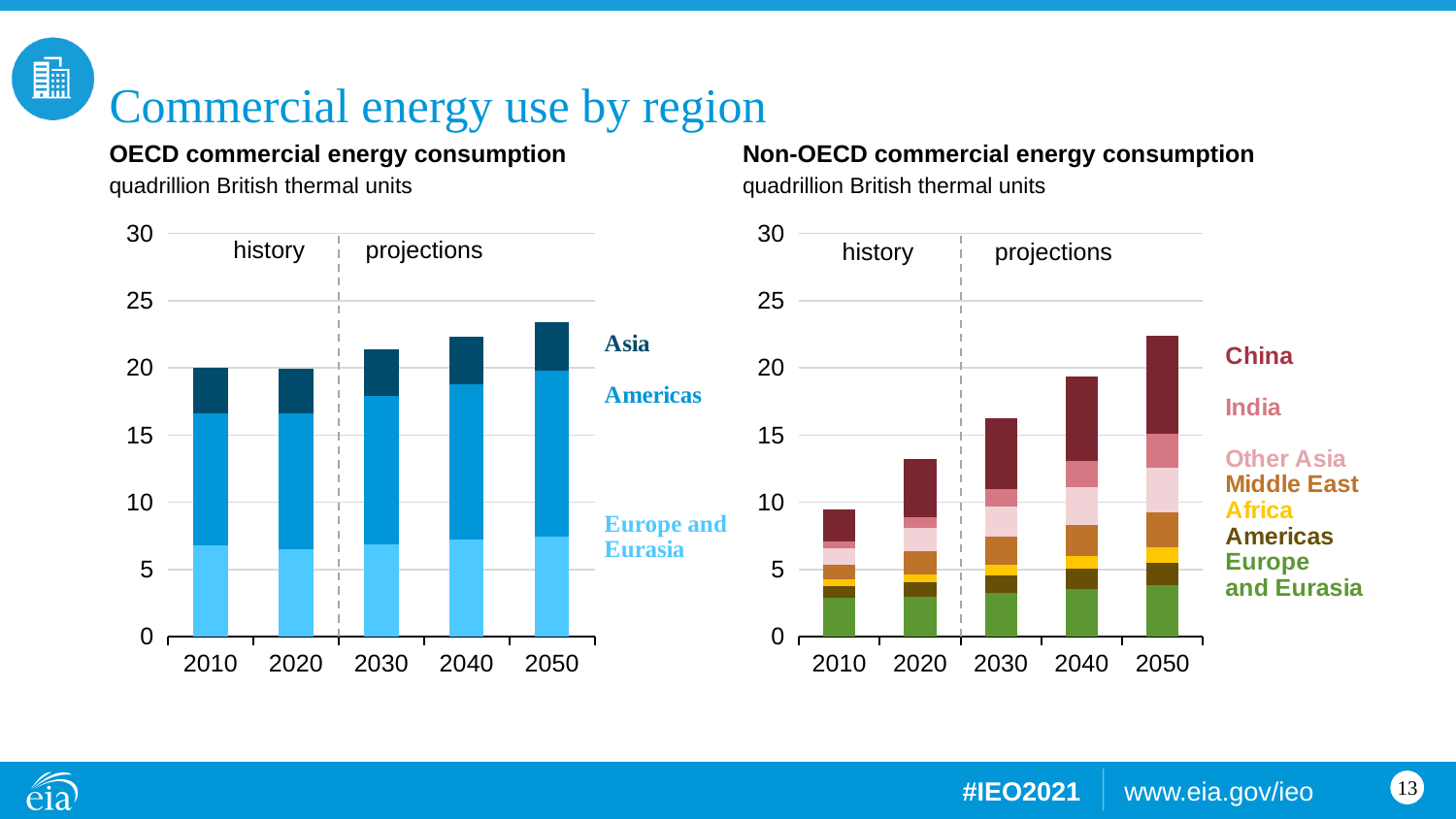
In the OECD commercial energy consumption chart, is the total for 2030 greater or less than 20? greater How many regions are listed in the legend of the Non-OECD commercial energy consumption chart? 7 In the OECD commercial energy consumption chart, which year has the highest total bar? 2050 Do the total bars in the Non-OECD commercial energy consumption chart rise or fall from 2010 to 2050? rise Which is larger in 2010: the total OECD commercial energy consumption or the total Non-OECD commercial energy consumption? OECD How many years are shown on the x axis of the Non-OECD commercial energy consumption chart? 5 How many regions are listed in the legend of the OECD commercial energy consumption chart? 3 In the Non-OECD commercial energy consumption chart, which year has the lowest total bar? 2010 In the Non-OECD commercial energy consumption chart, is the total for 2050 greater or less than 20? greater What kind of chart is the OECD commercial energy consumption chart? stacked bar chart In the Non-OECD commercial energy consumption chart, which year has the highest total bar? 2050 In the Non-OECD commercial energy consumption chart, is the total for 2010 greater or less than 10? less